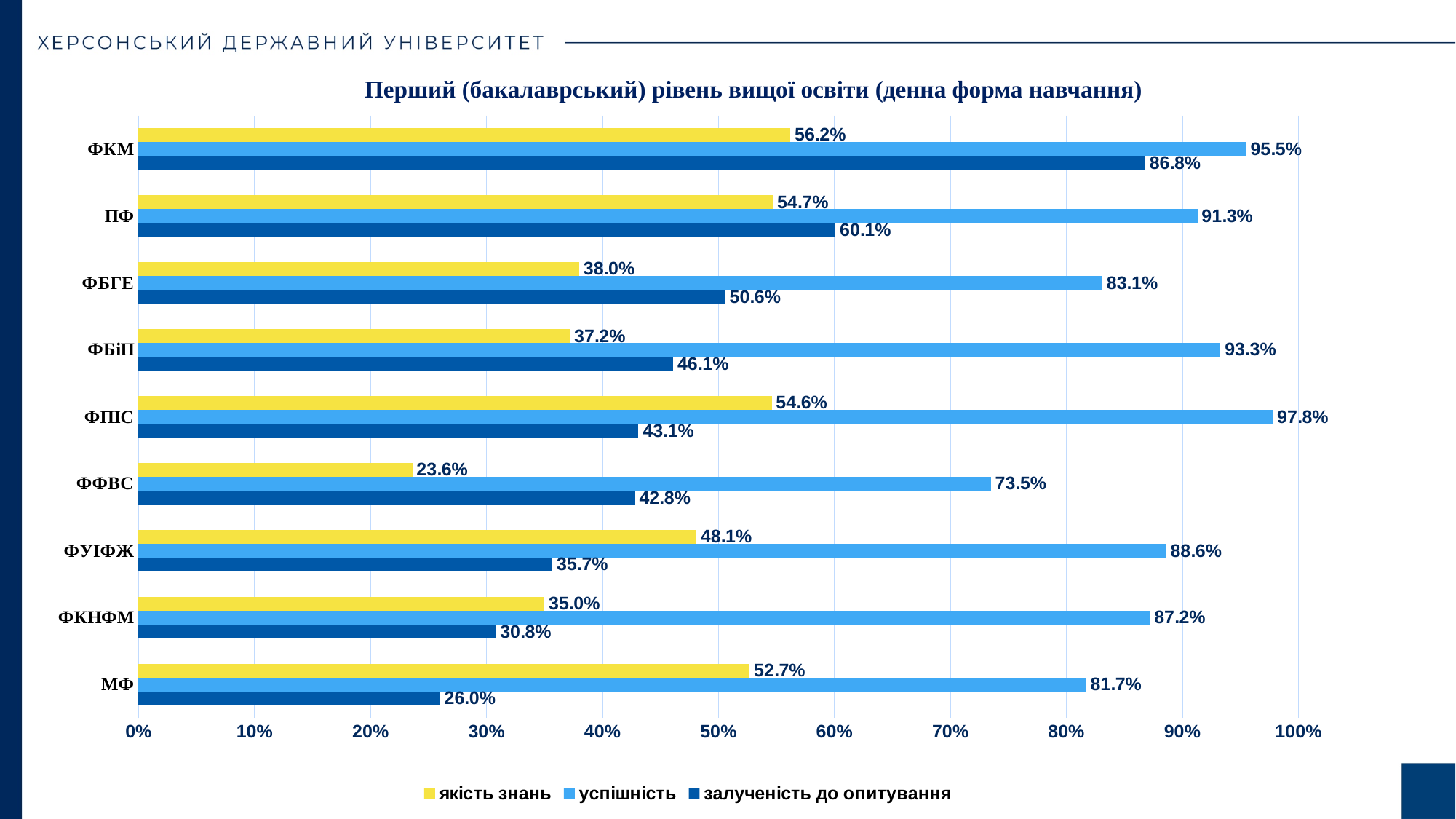
How many series does the legend list? 3 What is the difference between the успішність and якість знань values for ФКМ? 39.3 percentage points Which faculty has the highest залученість до опитування value? ФКМ What is the якість знань value for ФУІФЖ? 48.1% What type of chart is shown on the slide? Bar chart What is the залученість до опитування value for МФ? 26.0% What is the title of the chart? Перший (бакалаврський) рівень вищої освіти (денна форма навчання) Which faculty has the highest успішність value? ФПІС What is the успішність value for ФПІС? 97.8% How many faculties (categories) are shown on the chart? 9 Which is larger: the залученість до опитування value for ПФ or for ФБГЕ? ПФ Which faculty has the lowest якість знань value? ФФВС